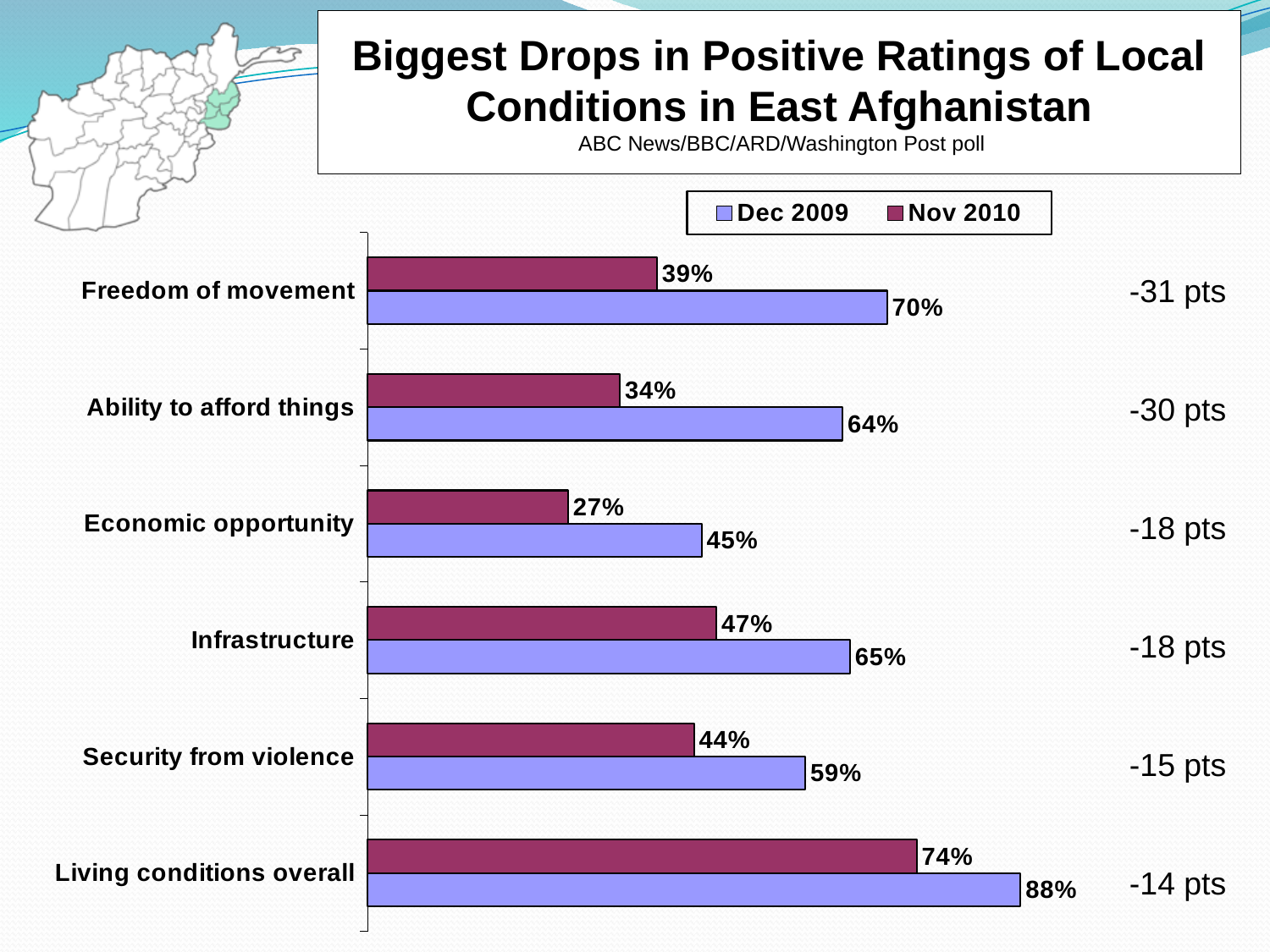
What is the Nov 2010 value for Freedom of movement? 39% What kind of chart is shown on the slide? Bar chart What is the difference between the Dec 2009 and Nov 2010 values for Ability to afford things? 30 pts Which category has the lowest Dec 2009 value? Economic opportunity Which is larger: the Nov 2010 value for Infrastructure or the Nov 2010 value for Security from violence? Infrastructure How many categories are shown on the chart? 6 What is the Dec 2009 value for Living conditions overall? 88% What is the Dec 2009 value for Economic opportunity? 45% Which category has the highest Nov 2010 value? Living conditions overall Which category shows the largest drop in points between Dec 2009 and Nov 2010? Freedom of movement How many series does the legend list? 2 Which poll is cited as the source under the chart title? ABC News/BBC/ARD/Washington Post poll